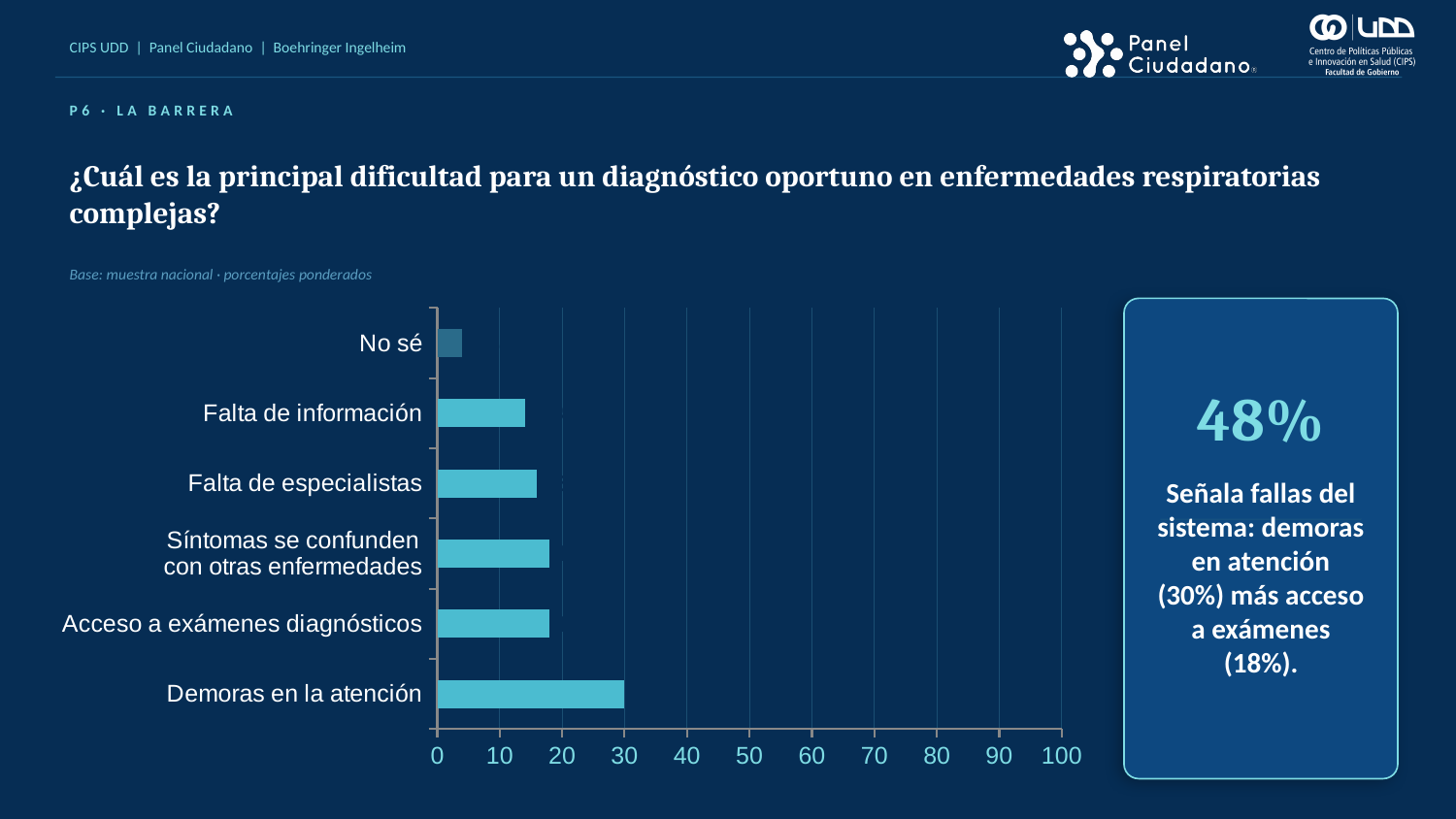
What is the difference between the values for Demoras en la atención and Acceso a exámenes diagnósticos? 12% What percentage is highlighted in the callout box to the right of the chart? 48% How many categories does the chart show? 6 Which category has the lowest value? No sé Is the value for No sé greater or less than 10? less Which category has the highest value? Demoras en la atención Is the value for Falta de especialistas greater or less than 10? greater What kind of chart is shown on the slide? bar chart What is the value for Demoras en la atención? 30% Is the value for Falta de información greater or less than 20? less Which is larger, the value for Falta de información or the value for Demoras en la atención? Demoras en la atención What is the value for Acceso a exámenes diagnósticos? 18%